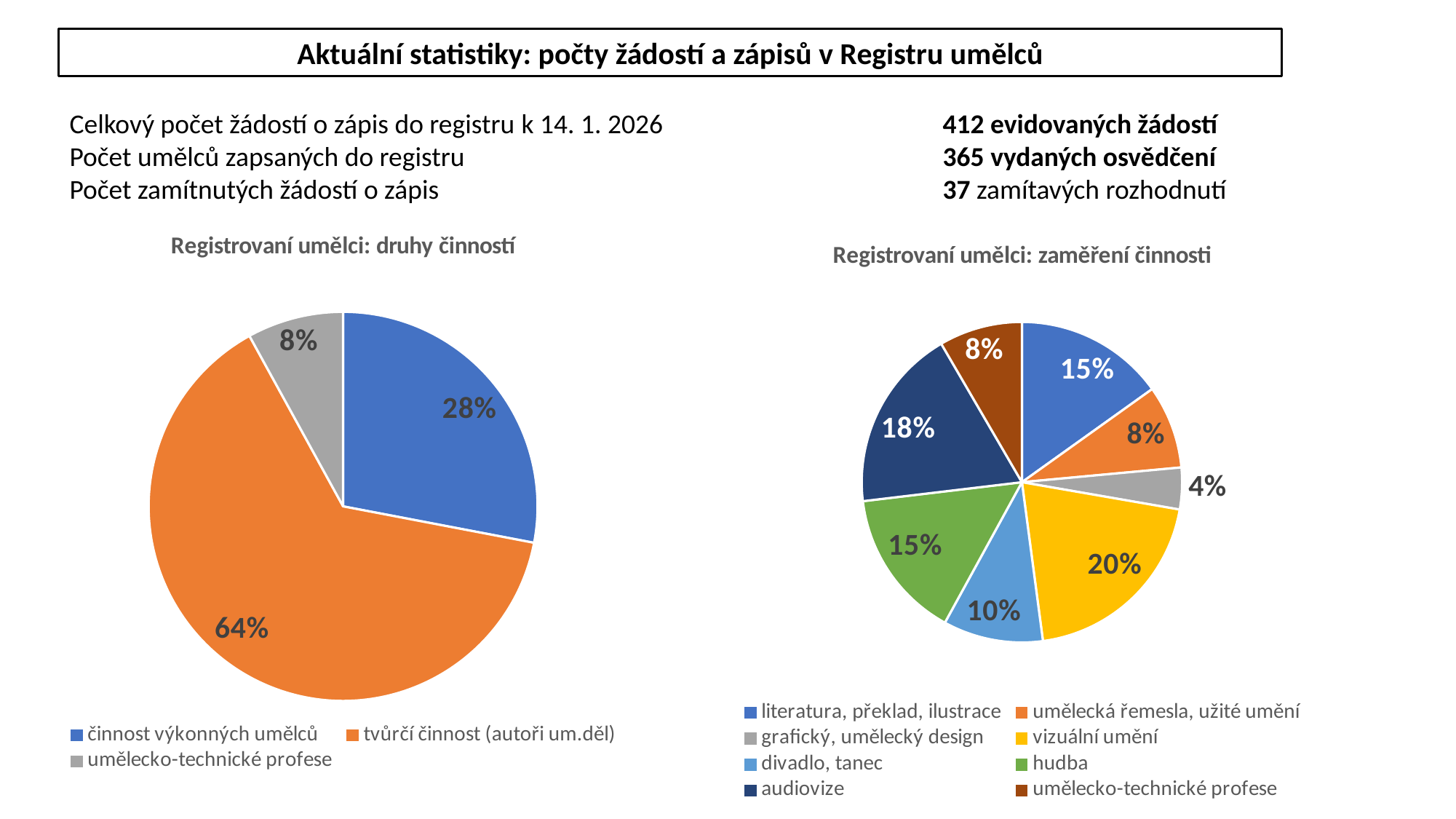
In the chart 'Registrovaní umělci: druhy činností', how many categories does the legend list? 3 In the chart 'Registrovaní umělci: zaměření činnosti', how many categories does the legend list? 8 In the chart 'Registrovaní umělci: zaměření činnosti', which category has the smallest slice? grafický, umělecký design In the chart 'Registrovaní umělci: druhy činností', what share does 'tvůrčí činnost (autoři um.děl)' have? 64% In the chart 'Registrovaní umělci: druhy činností', which category has the smallest slice? umělecko-technické profese In the chart 'Registrovaní umělci: druhy činností', what is the difference in percentage points between 'tvůrčí činnost (autoři um.děl)' and 'činnost výkonných umělců'? 36 In the chart 'Registrovaní umělci: zaměření činnosti', which category has the largest slice? vizuální umění In the chart 'Registrovaní umělci: zaměření činnosti', what share does 'vizuální umění' have? 20% In the chart 'Registrovaní umělci: druhy činností', what share does 'činnost výkonných umělců' have? 28% In the chart 'Registrovaní umělci: zaměření činnosti', which is larger: 'hudba' or 'divadlo, tanec'? hudba What type of chart is 'Registrovaní umělci: zaměření činnosti'? pie chart